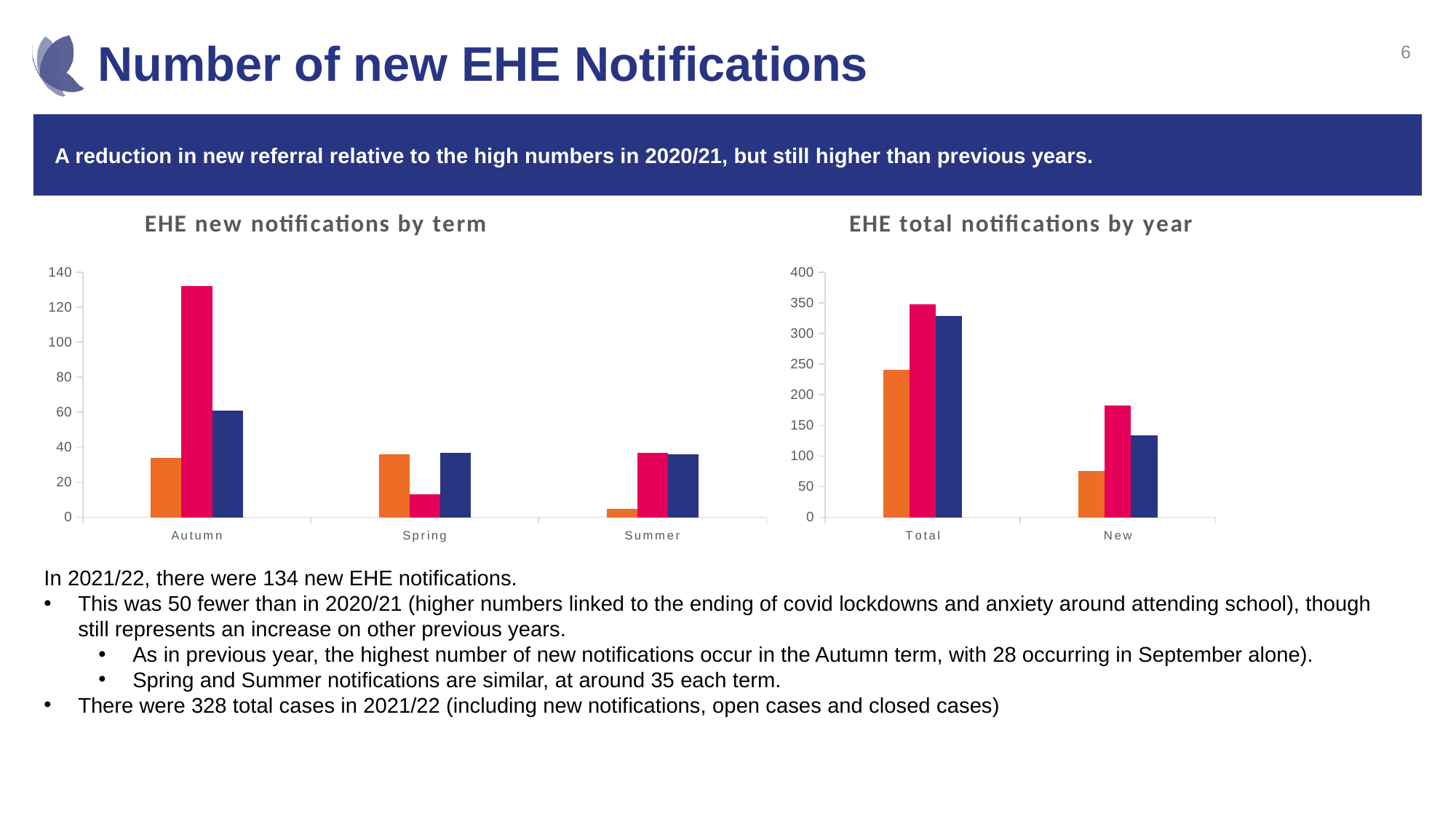
What is the title of the chart on the right of the slide? EHE total notifications by year What is the title of the chart on the left of the slide? EHE new notifications by term In the 'EHE new notifications by term' chart, is the shortest bar for Summer greater or less than 20? less In the 'EHE total notifications by year' chart, is the tallest bar for New greater or less than 200? less In the 'EHE new notifications by term' chart, how many terms are shown on the x axis? 3 In the 'EHE total notifications by year' chart, how many categories are shown on the x axis? 2 In the 'EHE new notifications by term' chart, which term has the tallest bar? Autumn What kind of chart is the 'EHE total notifications by year' chart? bar chart In the 'EHE new notifications by term' chart, is the tallest bar for Autumn greater or less than 120? greater In the 'EHE new notifications by term' chart, how many bars are plotted for each term? 3 What kind of chart is the 'EHE new notifications by term' chart? bar chart